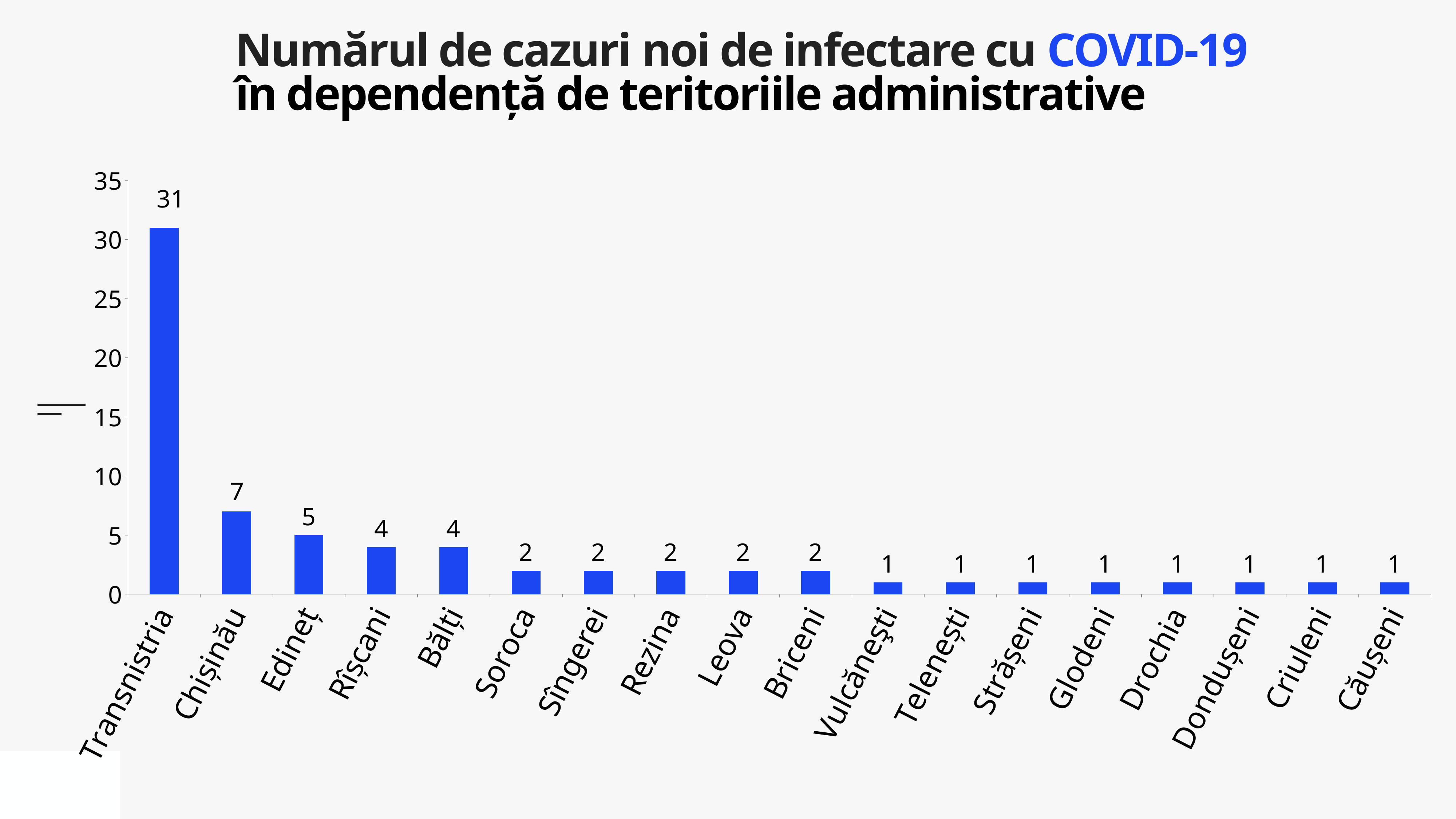
How many territories are shown on the x axis? 18 Which territory has the highest number of new cases? Transnistria What is the value for Drochia? 1 Is the value for Transnistria greater or less than 30? greater What is the difference between the values for Edineț and Briceni? 3 Which is larger, the value for Rîșcani or the value for Rezina? Rîșcani What is the difference between the values for Transnistria and Chișinău? 24 What is the value for Soroca? 2 What is the value for Chișinău? 7 What kind of chart is shown on the slide? Bar chart What is the value for Edineț? 5 What is the value for Transnistria? 31